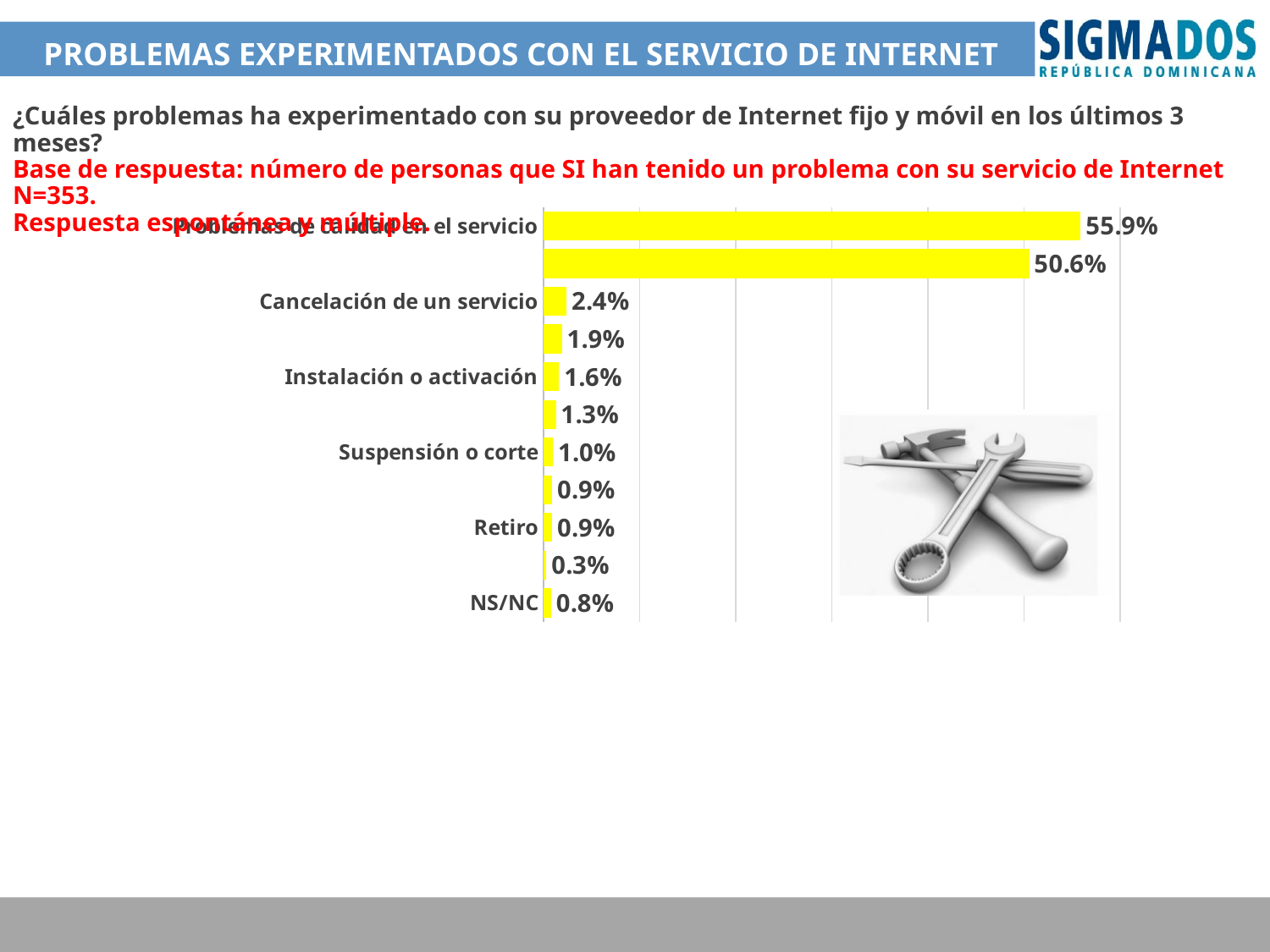
What is the value for Suspensión o corte? 1.0% What is the value for Cancelación de un servicio? 2.4% What is the value for Instalación o activación? 1.6% What is the value for NS/NC? 0.8% What kind of chart is shown on the slide? bar chart How many bars are plotted in the chart? 11 What is the difference between the values for Cancelación de un servicio and Instalación o activación? 0.8% What is the lowest value shown in the chart? 0.3% Which is larger, the value for Cancelación de un servicio or the value for Suspensión o corte? Cancelación de un servicio What is the value for Retiro? 0.9% What colour are the bars in the chart? yellow What is the highest value shown in the chart? 55.9%